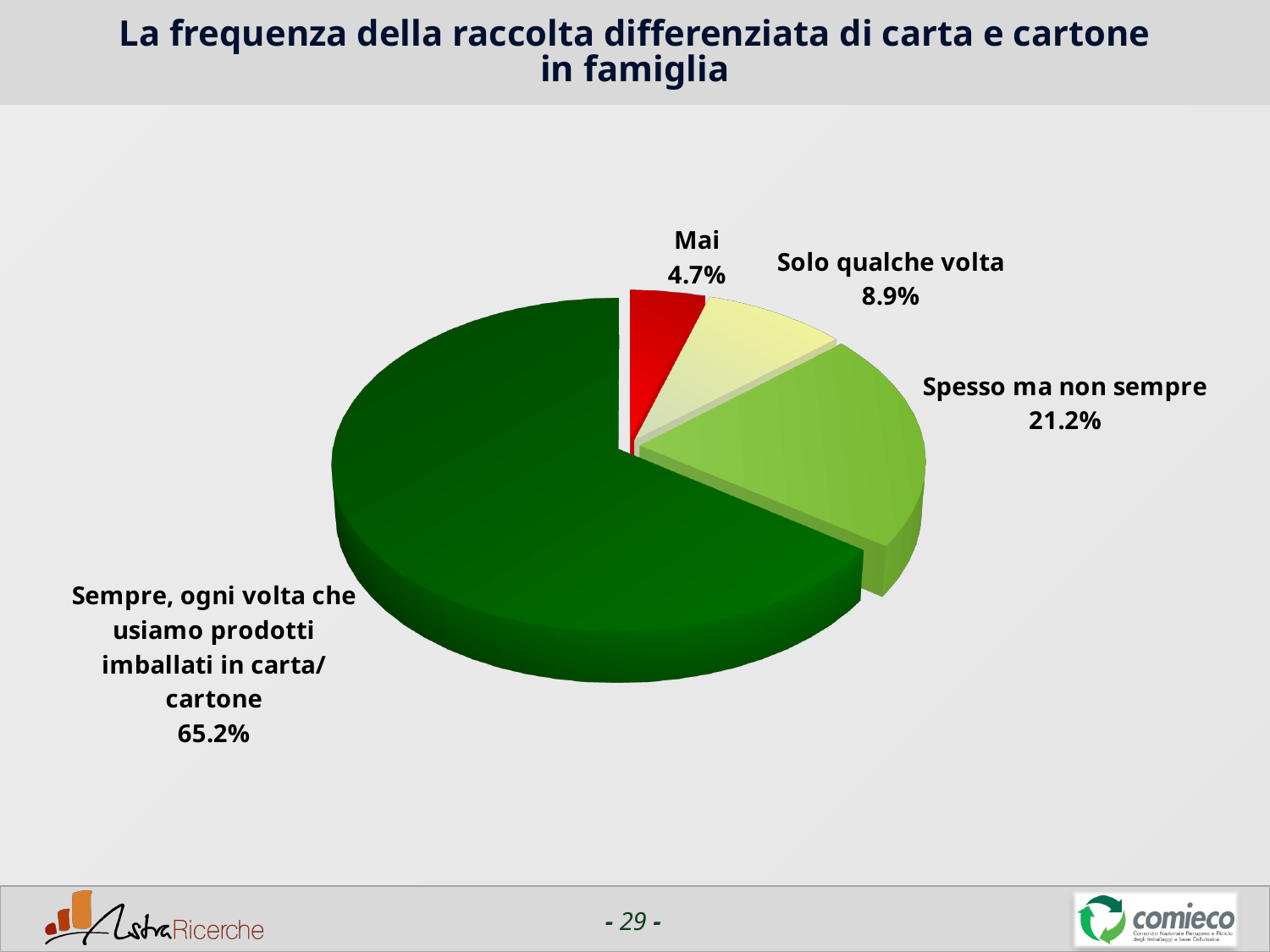
Which category has the smallest share of the pie? Mai What percentage is shown for "Spesso ma non sempre"? 21.2% Which category has the largest share of the pie? Sempre, ogni volta che usiamo prodotti imballati in carta/cartone What kind of chart is shown on the slide? pie chart What percentage is shown for "Solo qualche volta"? 8.9% What is the difference in percentage points between "Spesso ma non sempre" and "Solo qualche volta"? 12.3 What is the difference in percentage points between "Solo qualche volta" and "Mai"? 4.2 What percentage is shown for "Sempre, ogni volta che usiamo prodotti imballati in carta/cartone"? 65.2% Which is larger, the share for "Spesso ma non sempre" or the share for "Solo qualche volta"? Spesso ma non sempre How many slices does the pie chart have? 4 What is the title of the chart on the slide? La frequenza della raccolta differenziata di carta e cartone in famiglia What percentage is shown for "Mai"? 4.7%